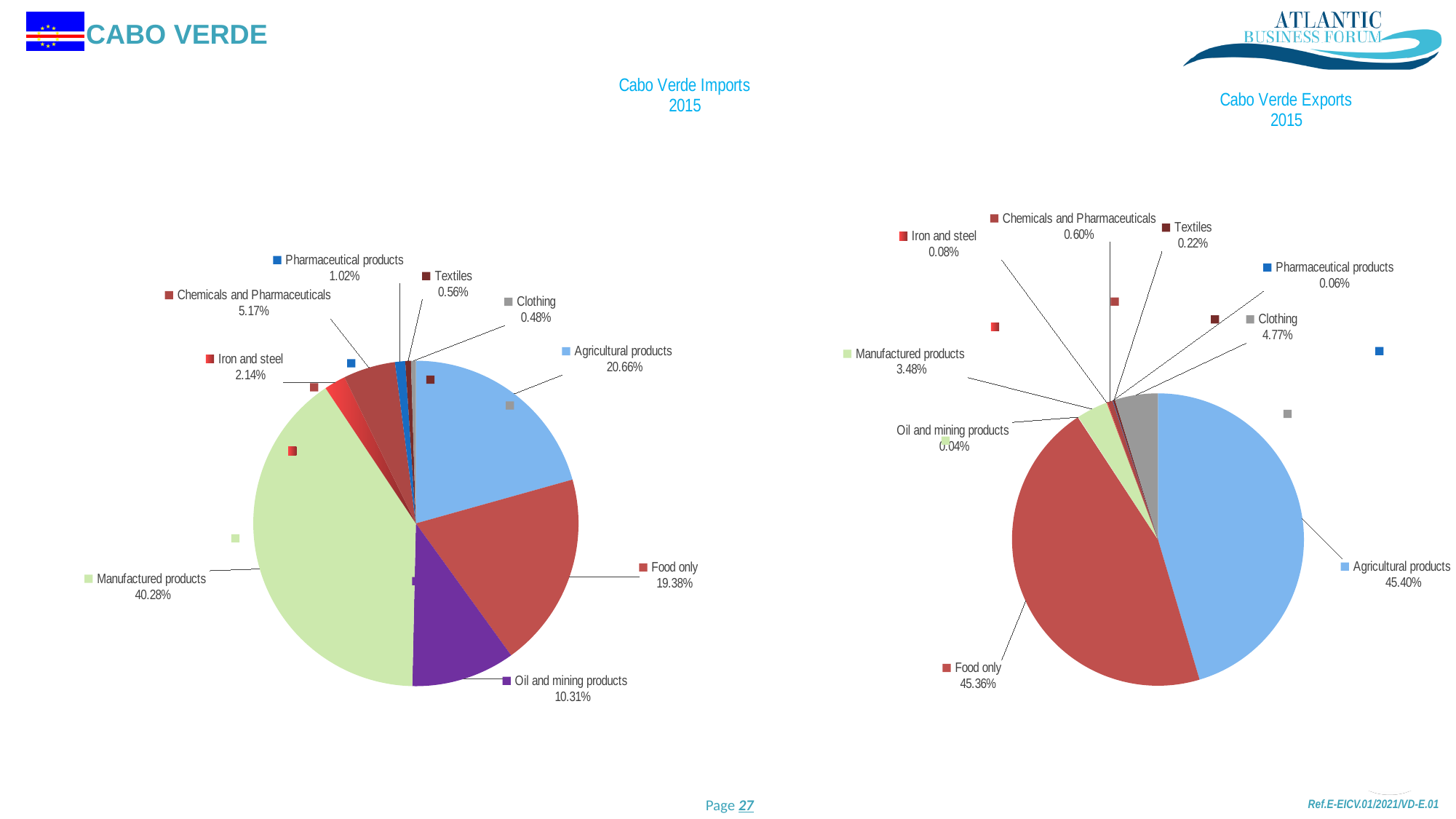
In the Cabo Verde Exports 2015 chart, which is larger: the share for Manufactured products or the share for Clothing? Clothing What is the title of the chart on the left side of the slide? Cabo Verde Imports 2015 In the Cabo Verde Imports 2015 chart, what is the share for Agricultural products? 20.66% In the Cabo Verde Exports 2015 chart, what is the share for Food only? 45.36% What type of chart is used on this slide? Pie chart In the Cabo Verde Imports 2015 chart, what is the combined share of Textiles and Clothing? 1.04% In the Cabo Verde Exports 2015 chart, what is the share for Clothing? 4.77% In the Cabo Verde Imports 2015 chart, what is the share for Manufactured products? 40.28% How many categories are shown in the Cabo Verde Exports 2015 chart? 9 In the Cabo Verde Imports 2015 chart, which category has the smallest share? Clothing In the Cabo Verde Imports 2015 chart, what is the difference between the shares of Agricultural products and Food only? 1.28% In the Cabo Verde Imports 2015 chart, which category has the largest share? Manufactured products